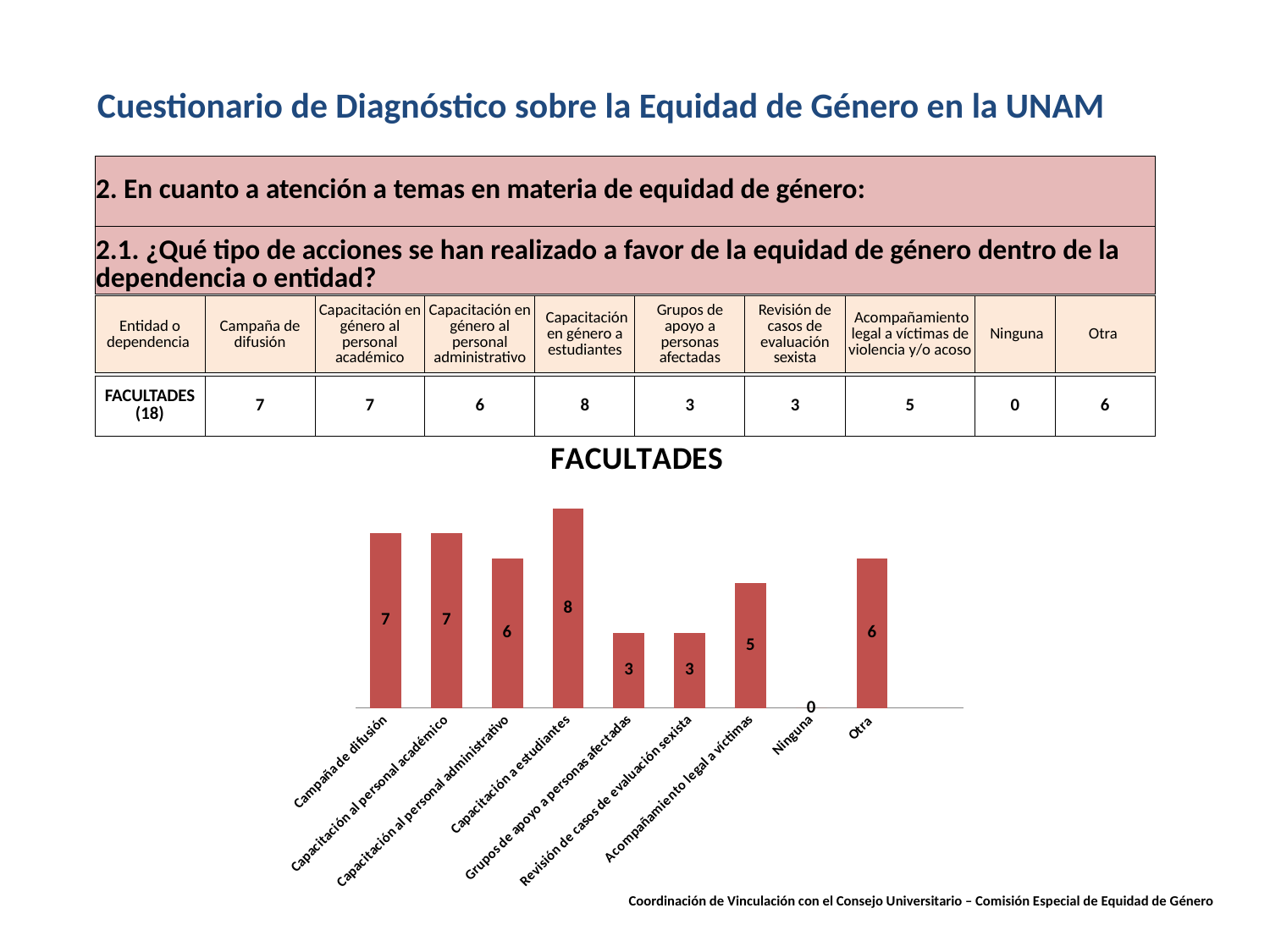
How many categories are shown in the chart? 9 What is the value for Capacitación a estudiantes? 8 What kind of chart is shown on the slide? Bar chart What is the title of the chart? FACULTADES Which is larger, Campaña de difusión or Acompañamiento legal a víctimas? Campaña de difusión What is the value for Otra? 6 Which category has the highest value? Capacitación a estudiantes What is the value for Ninguna? 0 What is the difference between Capacitación a estudiantes and Grupos de apoyo a personas afectadas? 5 What is the value for Acompañamiento legal a víctimas? 5 Which category has the lowest value? Ninguna What is the difference between Capacitación al personal académico and Capacitación al personal administrativo? 1